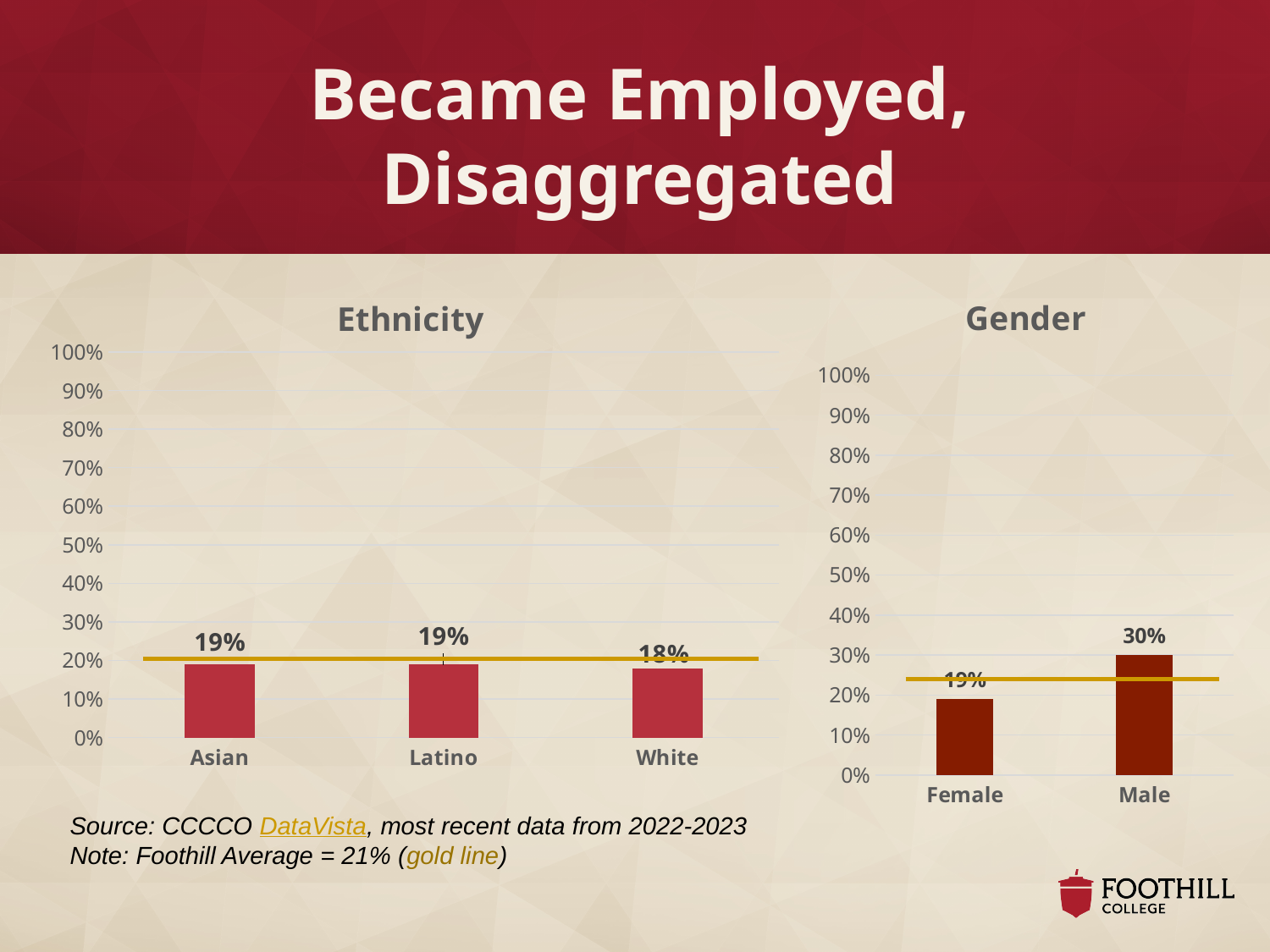
In the Gender chart, what is the value for Female? 19% What kind of chart is the Gender chart? Bar chart In the Ethnicity chart, what is the value for Asian? 19% In the Gender chart, what is the difference between the Male and Female values? 11% In the Gender chart, is the value for Male greater or less than 20%? greater According to the note on the slide, what does the gold line on the charts represent? Foothill Average = 21% In the Gender chart, which category has the highest value? Male In the Ethnicity chart, which category has the lowest value? White In the Ethnicity chart, what is the value for White? 18% How many categories are shown in the Ethnicity chart? 3 In the Gender chart, what is the value for Male? 30% In the Gender chart, which is larger, the value for Male or the value for Female? Male